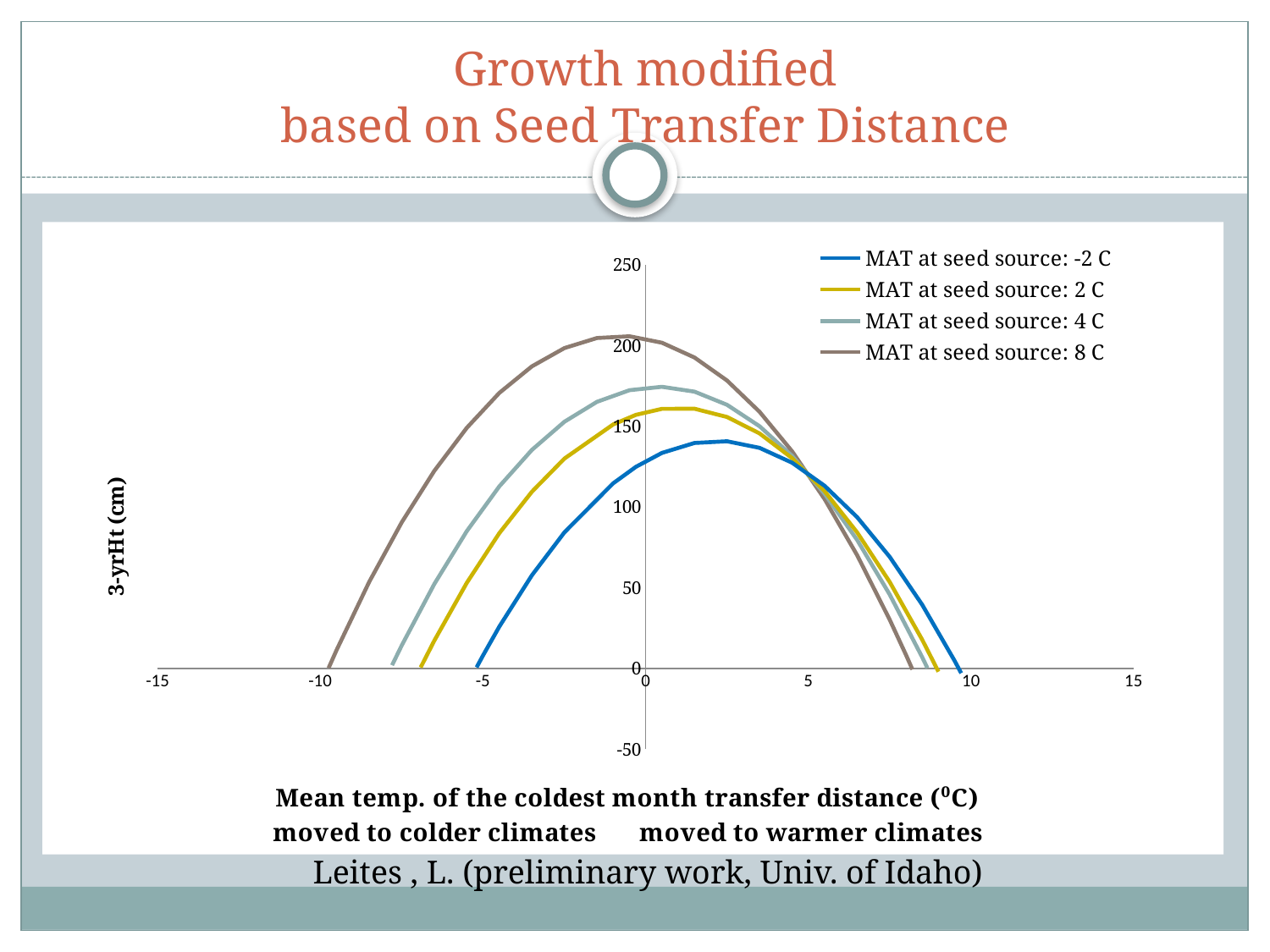
At a transfer distance of 0, which series has the higher 3-yrHt value: 'MAT at seed source: 8 C' or 'MAT at seed source: -2 C'? MAT at seed source: 8 C Is the peak value of the 'MAT at seed source: 8 C' series greater or less than 150? greater What kind of chart is shown on the slide? line chart How many series does the legend list? 4 How do the values of the 'MAT at seed source: 8 C' series change as the transfer distance increases from -10 to 10? rise then fall What colour is the line for 'MAT at seed source: -2 C'? blue Is the peak value of the 'MAT at seed source: 4 C' series greater or less than 150? greater Which series has the lowest peak 3-yrHt value? MAT at seed source: -2 C What is the label of the vertical axis? 3-yrHt (cm) Which series reaches the highest peak 3-yrHt value? MAT at seed source: 8 C Is the peak value of the 'MAT at seed source: -2 C' series greater or less than 150? less Which series extends furthest to the left (most negative transfer distance) before reaching 0? MAT at seed source: 8 C